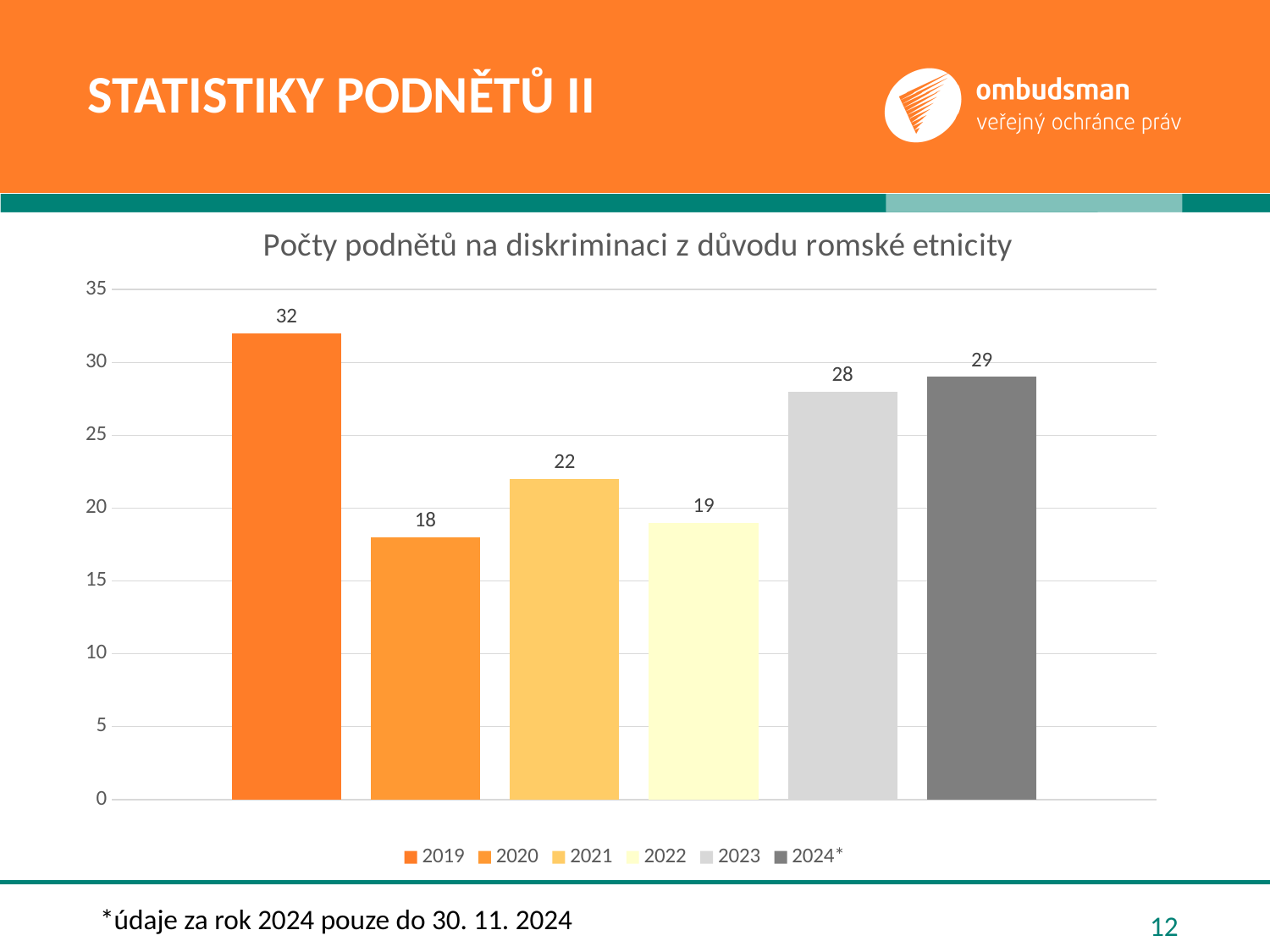
Which year has the highest value? 2019 Is the value for 2023 greater or less than 25? greater What kind of chart is shown on the slide? bar chart What is the difference between the values for 2023 and 2021? 6 What is the value for 2019? 32 Which year has the lowest value? 2020 What is the value for 2024*? 29 What is the title of the chart? Počty podnětů na diskriminaci z důvodu romské etnicity What is the value for 2022? 19 Which is larger, the value for 2021 or the value for 2022? 2021 How many bars are shown in the chart? 6 What is the difference between the values for 2019 and 2020? 14